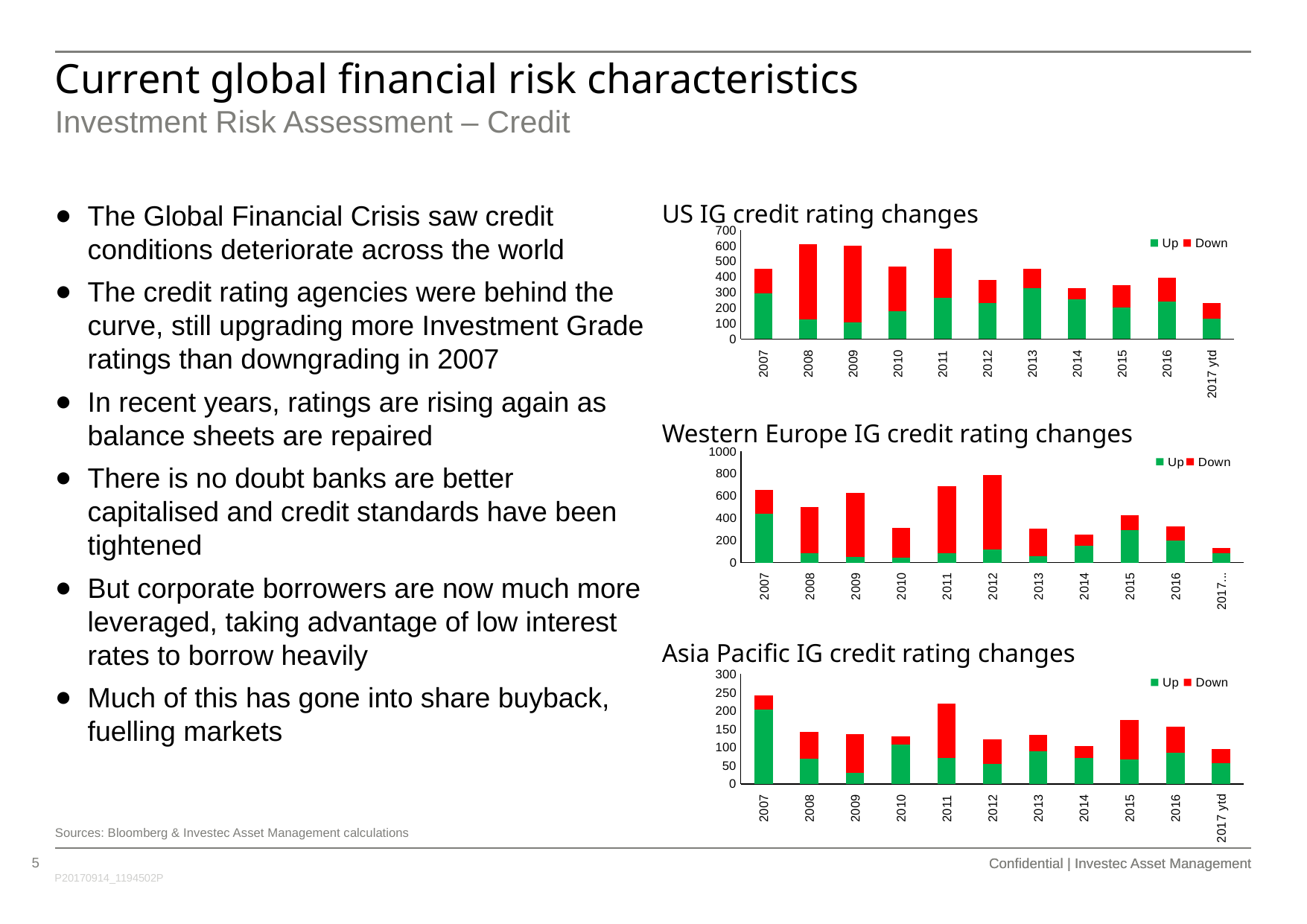
What kind of chart is the 'US IG credit rating changes' chart? Stacked bar chart In the 'Western Europe IG credit rating changes' chart, is the total bar for 2010 greater or less than 400? less What are the two legend entries in the 'Asia Pacific IG credit rating changes' chart? Up and Down In the 'US IG credit rating changes' chart, is the total bar for 2008 greater or less than 500? greater How many series does the legend of the 'Western Europe IG credit rating changes' chart list? 2 How many year categories are shown on the x axis of the 'Asia Pacific IG credit rating changes' chart? 11 In the 'US IG credit rating changes' chart, which category has the lowest total bar? 2017 ytd In the 'Asia Pacific IG credit rating changes' chart, is the total bar for 2007 greater or less than 200? greater In the 'US IG credit rating changes' chart, which total bar is larger, 2008 or 2017 ytd? 2008 How many charts are shown on the slide? 3 In the 'Western Europe IG credit rating changes' chart, which year has the highest total bar? 2012